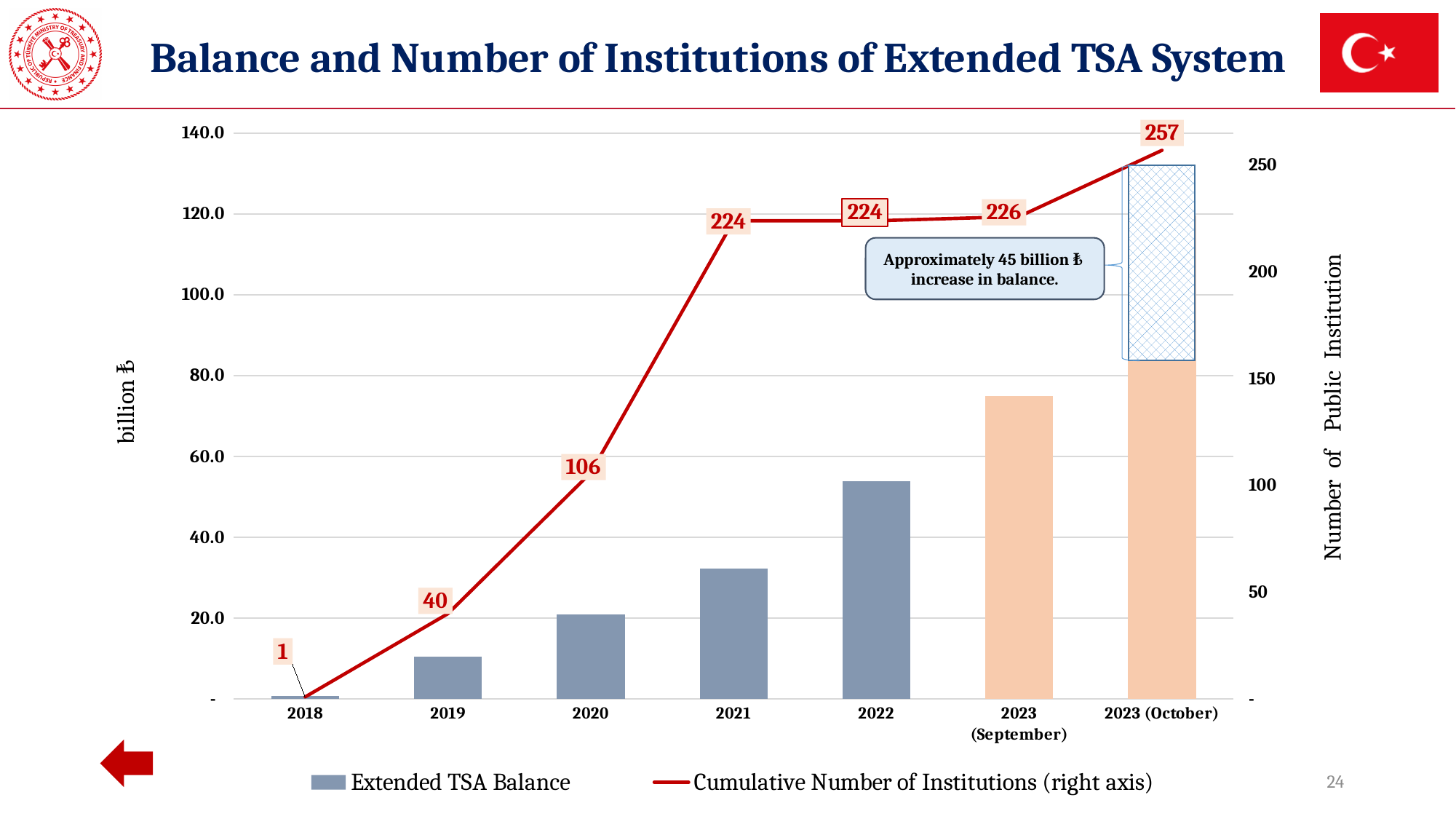
In which year is the cumulative number of institutions lowest? 2018 Is the Extended TSA Balance for 2021 greater or less than 40.0 billion ₺? less By how much did the cumulative number of institutions increase from 2020 to 2021? 118 Is the Extended TSA Balance for 2022 greater or less than 40.0 billion ₺? greater How many series does the legend list? 2 What is the cumulative number of institutions in 2023 (October)? 257 How many categories are shown on the x axis? 7 What is the difference in the cumulative number of institutions between 2023 (September) and 2023 (October)? 31 Which has a larger Extended TSA Balance, 2023 (September) or 2022? 2023 (September) What is the cumulative number of institutions in 2019? 40 What is the cumulative number of institutions in 2021? 224 Which category has the highest cumulative number of institutions? 2023 (October)